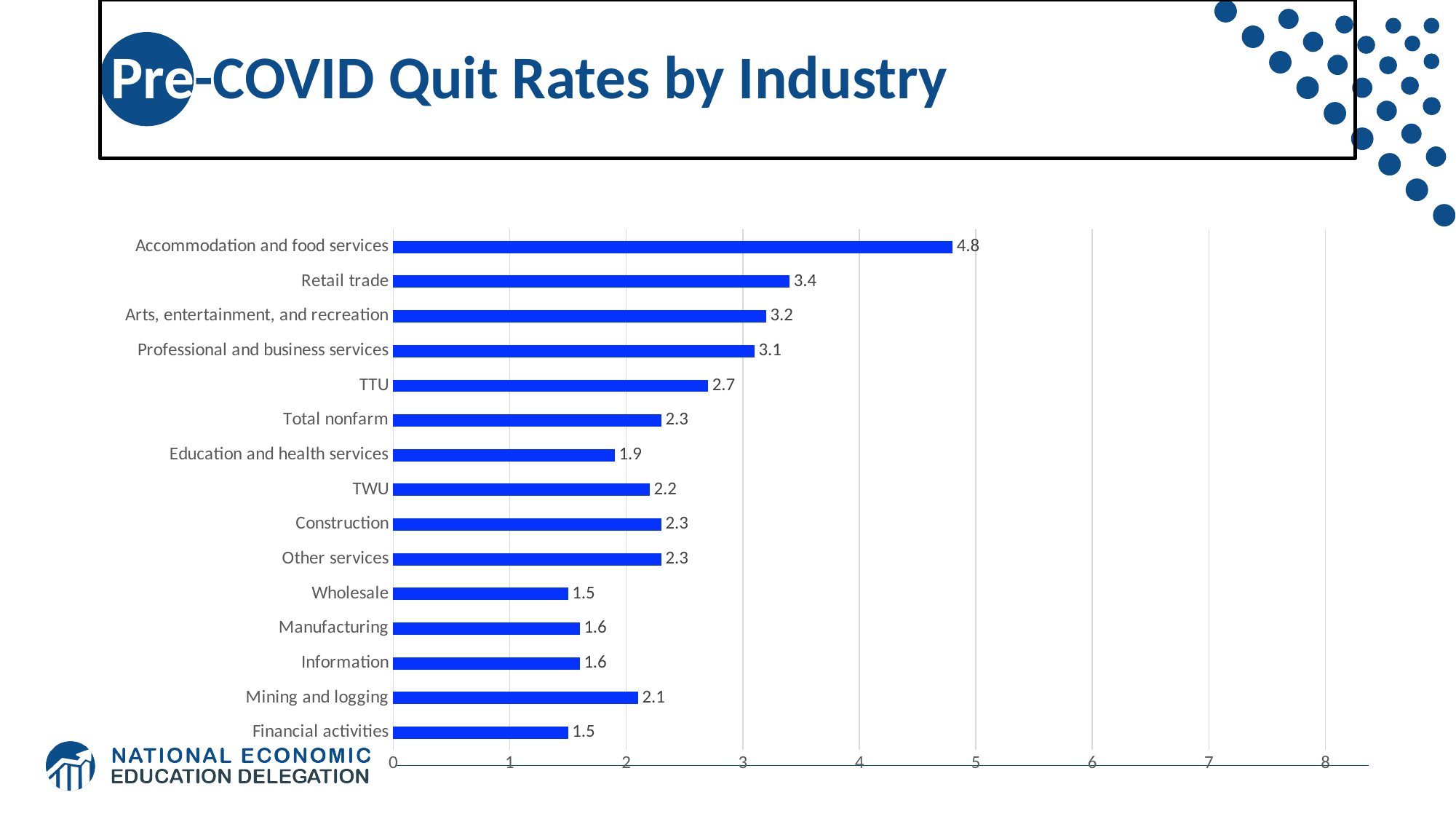
What is the quit rate for Accommodation and food services? 4.8 What is the quit rate for Mining and logging? 2.1 What kind of chart is shown on the slide? Bar chart What is the difference between the quit rates for Accommodation and food services and Retail trade? 1.4 Which has a higher quit rate, Arts, entertainment, and recreation or Professional and business services? Arts, entertainment, and recreation What is the quit rate for Education and health services? 1.9 What is the quit rate for Retail trade? 3.4 Which industry has the highest quit rate? Accommodation and food services What is the title of the slide? Pre-COVID Quit Rates by Industry How many industries are shown in the chart? 15 What is the difference between the quit rates for TTU and Total nonfarm? 0.4 Which has a higher quit rate, TWU or Wholesale? TWU